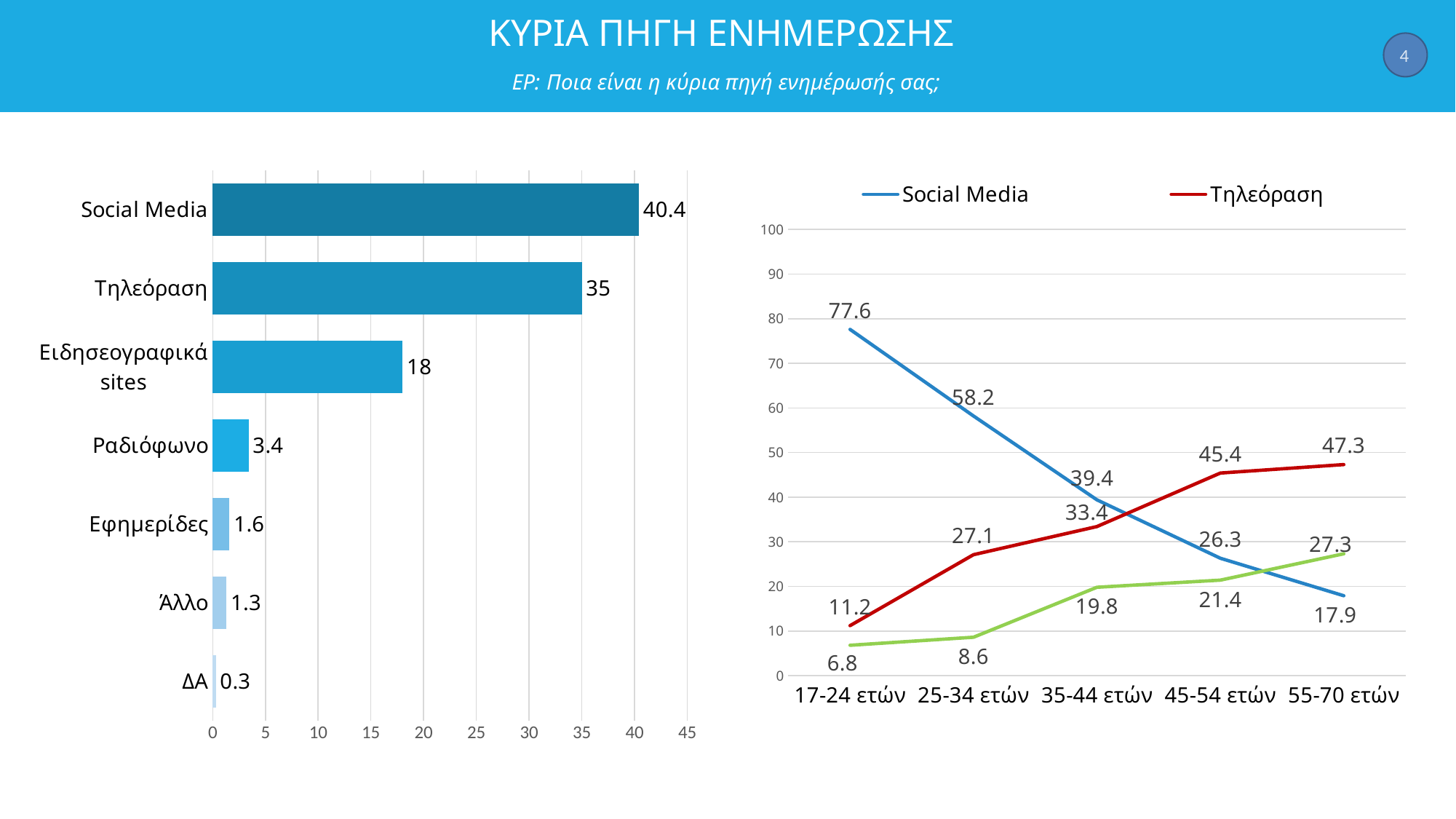
In the line chart on the right, what is the value for Social Media at 17-24 ετών? 77.6 In the bar chart on the left, which category has the highest value? Social Media In the bar chart on the left, what is the difference between the values for Social Media and Τηλεόραση? 5.4 In the bar chart on the left, how many categories are shown? 7 In the bar chart on the left, what is the value for Τηλεόραση? 35 What kind of chart is the chart on the left? Bar chart In the bar chart on the left, which is larger: the value for Ραδιόφωνο or the value for Εφημερίδες? Ραδιόφωνο In the line chart on the right, what is the difference between the Τηλεόραση values at 45-54 ετών and 35-44 ετών? 12 In the line chart on the right, how many series does the legend list? 2 In the line chart on the right, what is the value for Τηλεόραση at 55-70 ετών? 47.3 In the bar chart on the left, which category has the lowest value? ΔΑ In the line chart on the right, does the Social Media series rise or fall across the age groups from 17-24 ετών to 55-70 ετών? Fall